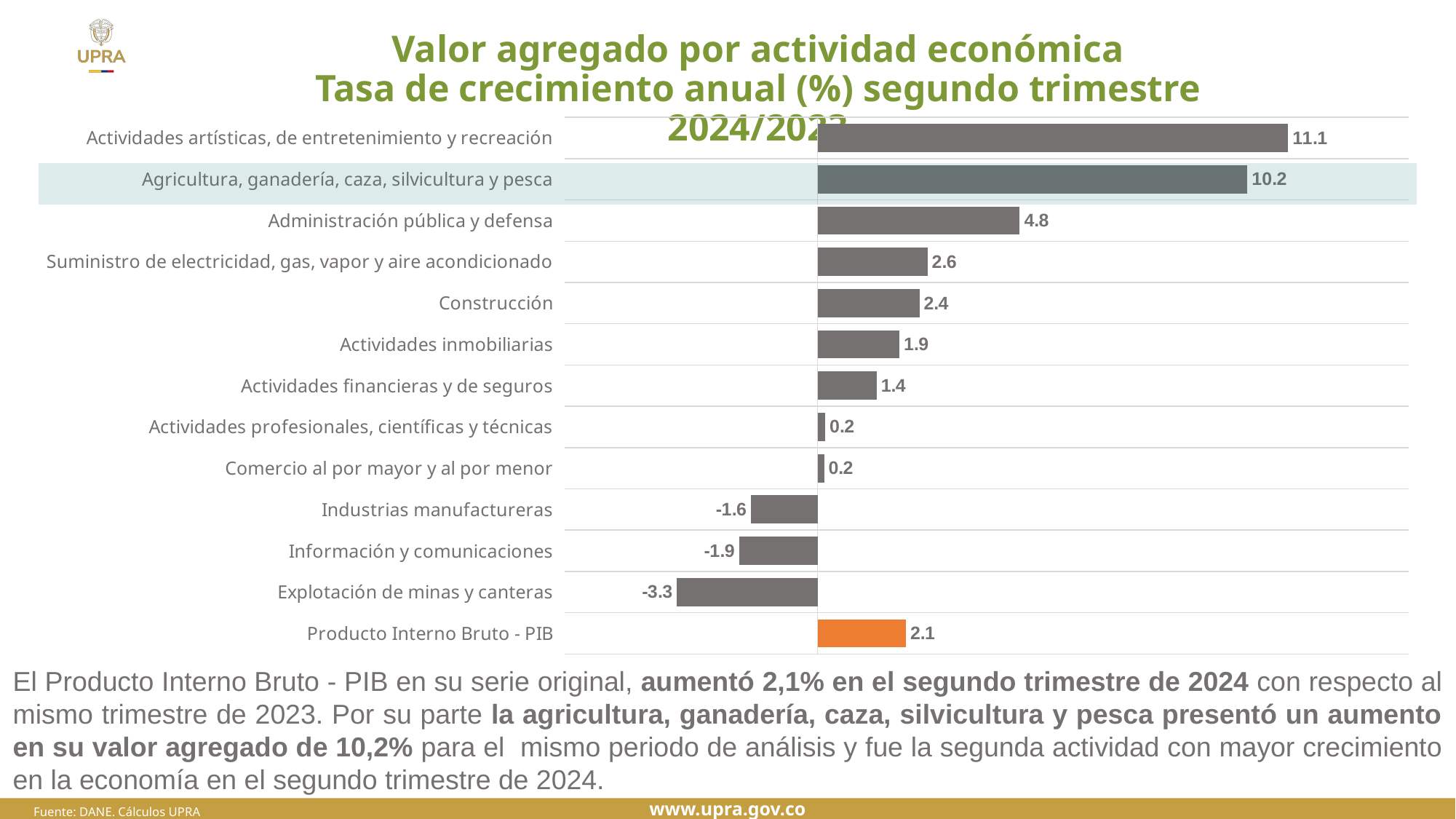
What is the value for Explotación de minas y canteras? -3.3 How many categories are shown in the chart? 13 Which bar is shown in orange rather than grey? Producto Interno Bruto - PIB What is the value for Producto Interno Bruto - PIB? 2.1 What is the value for Agricultura, ganadería, caza, silvicultura y pesca? 10.2 What kind of chart is shown on the slide? Bar chart Which category has the highest value? Actividades artísticas, de entretenimiento y recreación Which is larger, the value for Administración pública y defensa or the value for Construcción? Administración pública y defensa How many categories have a negative value? 3 What is the value for Industrias manufactureras? -1.6 Which category has the lowest value? Explotación de minas y canteras What is the difference between the values for Actividades artísticas, de entretenimiento y recreación and Agricultura, ganadería, caza, silvicultura y pesca? 0.9